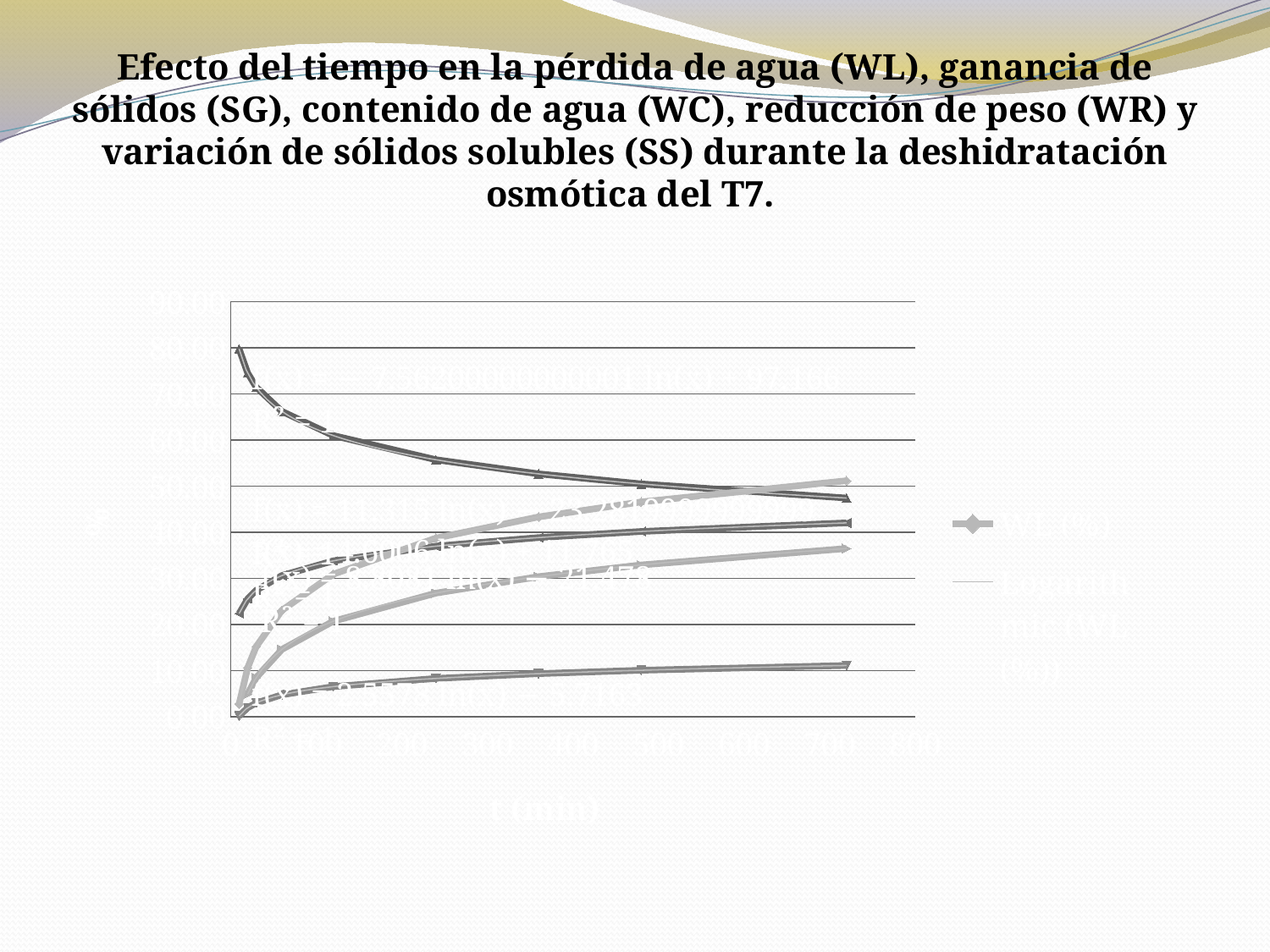
Is the value of the lowest series at t = 700 greater or less than 20? less Does the WL (%) series rise or fall as t (min) increases? rise What is the title of the x axis of the chart? t (min) Is the value of the WL (%) series at t = 700 greater or less than 40? greater What is the highest tick value shown on the y axis of the chart? 90.00 What kind of chart is shown on the slide? line chart Does the series that starts near 80 at t = 0 rise or fall as t (min) increases? fall